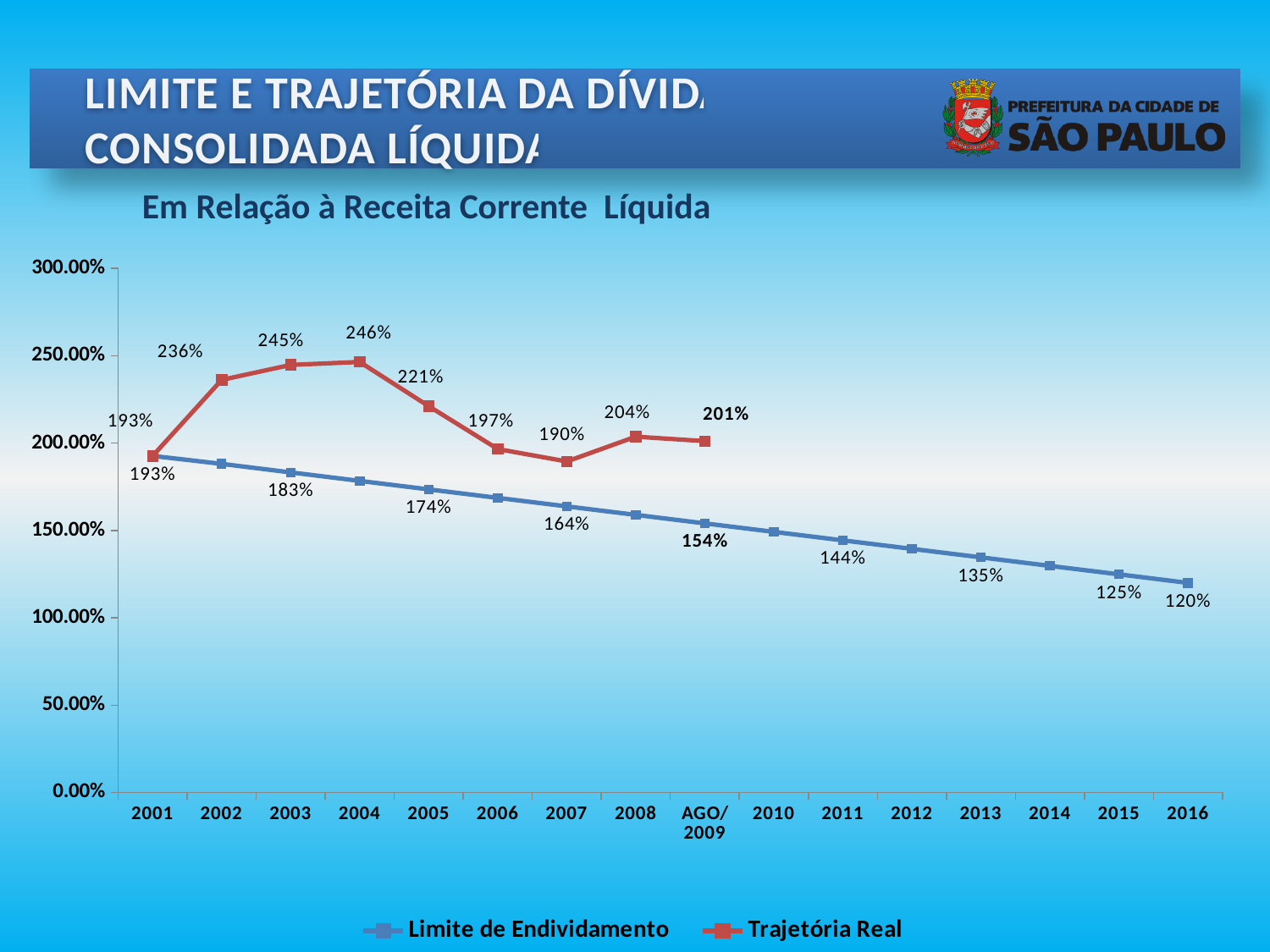
In which year is Limite de Endividamento at its lowest value? 2016 How many series does the legend list? 2 In which year does Trajetória Real reach its highest value? 2004 Which series has the larger value in 2007, Limite de Endividamento or Trajetória Real? Trajetória Real Does Limite de Endividamento rise or fall from 2001 to 2016? fall Is the value of Limite de Endividamento in 2014 greater or less than 150.00%? less What kind of chart is shown on the slide? line chart What is the value of Trajetória Real in 2004? 246% What is the difference between Limite de Endividamento in 2001 and in 2016? 73 percentage points How many categories are shown on the x axis? 16 What is the value of Limite de Endividamento in 2013? 135% What is the value of Trajetória Real at AGO/2009? 201%